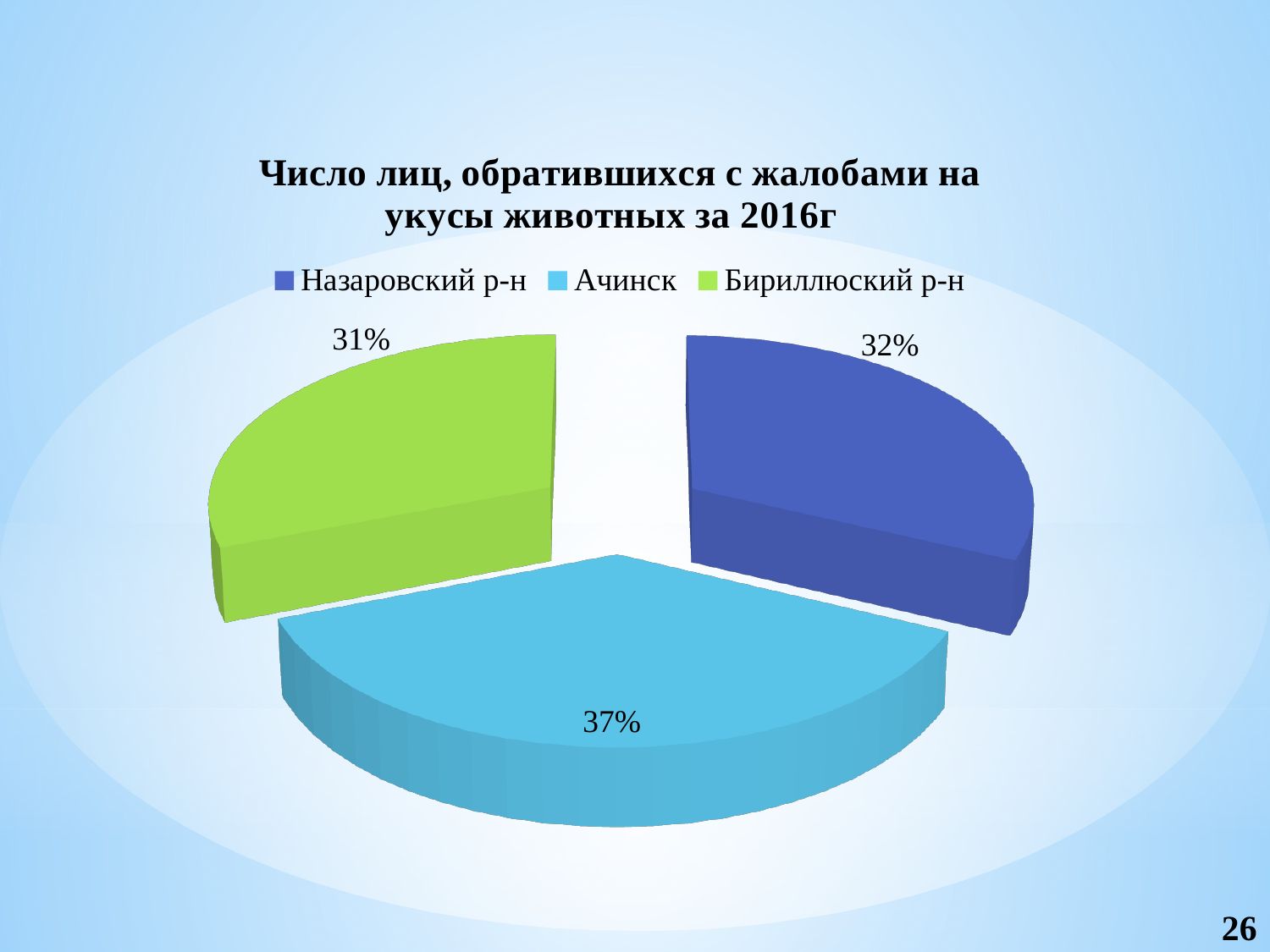
What kind of chart is shown on the slide? Pie chart Which category has the largest slice of the pie? Ачинск What share of the pie does Ачинск account for? 37% What is the difference in percentage points between the Назаровский р-н slice and the Бириллюский р-н slice? 1 What share of the pie does Назаровский р-н account for? 32% Which category has the smallest slice of the pie? Бириллюский р-н What share of the pie does Бириллюский р-н account for? 31% Which colour represents Ачинск in the legend? Light blue What is the title of the chart? Число лиц, обратившихся с жалобами на укусы животных за 2016г What is the difference in percentage points between the Ачинск slice and the Бириллюский р-н slice? 6 Which slice is larger: Ачинск or Назаровский р-н? Ачинск How many slices does the pie chart have? 3